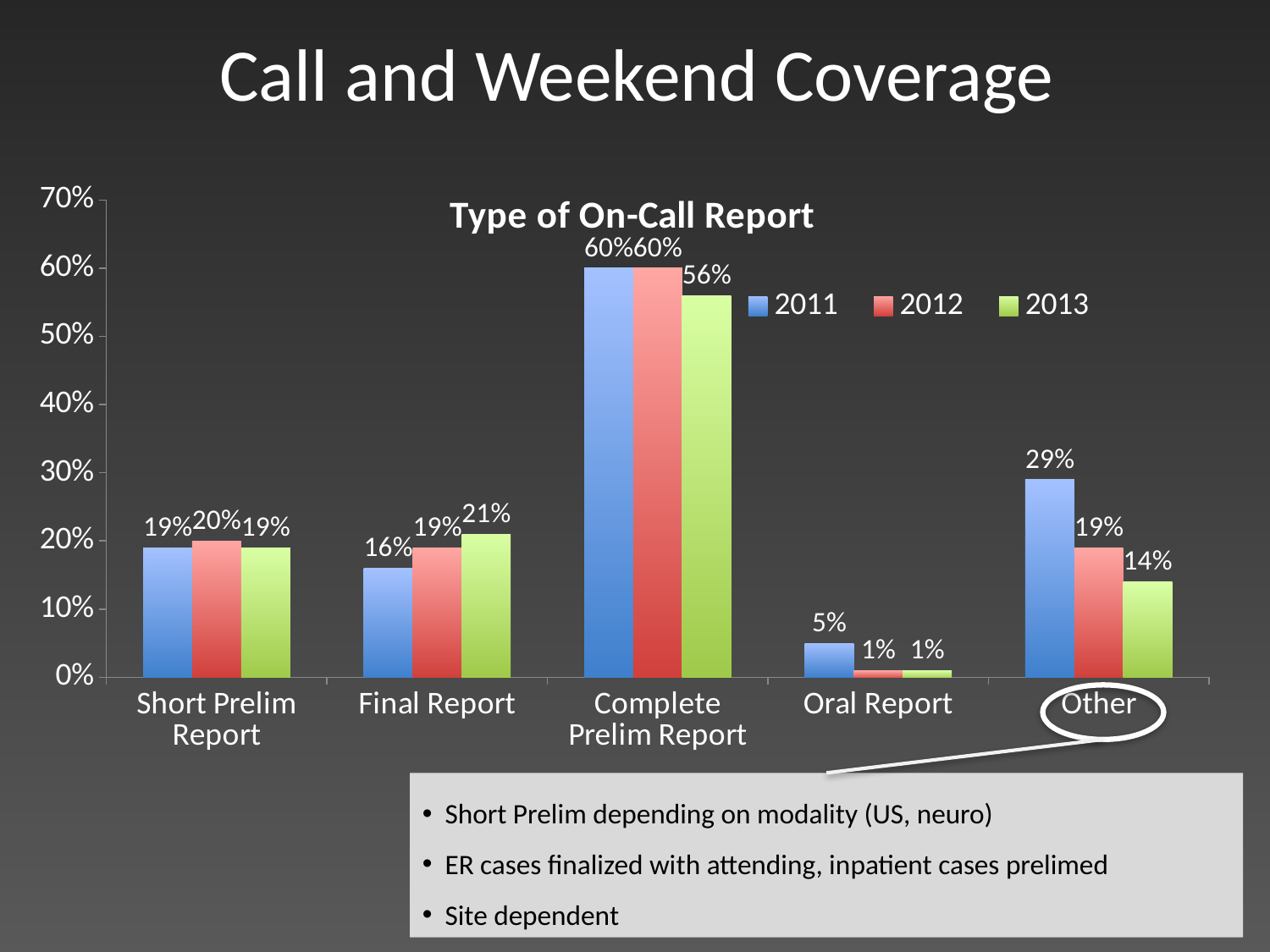
Which is larger for Final Report, the 2011 value or the 2013 value? 2013 What kind of chart is shown? bar chart What is the title of the chart? Type of On-Call Report How many series does the legend list? 3 How many categories are shown on the x axis? 5 What is the 2012 value for Final Report? 19% What is the 2011 value for Other? 29% Is the 2012 value for Complete Prelim Report greater or less than 50%? greater What is the 2013 value for Complete Prelim Report? 56% Which category has the highest 2011 value? Complete Prelim Report What is the difference between the 2011 and 2013 values for Other? 15% Which category has the lowest 2013 value? Oral Report